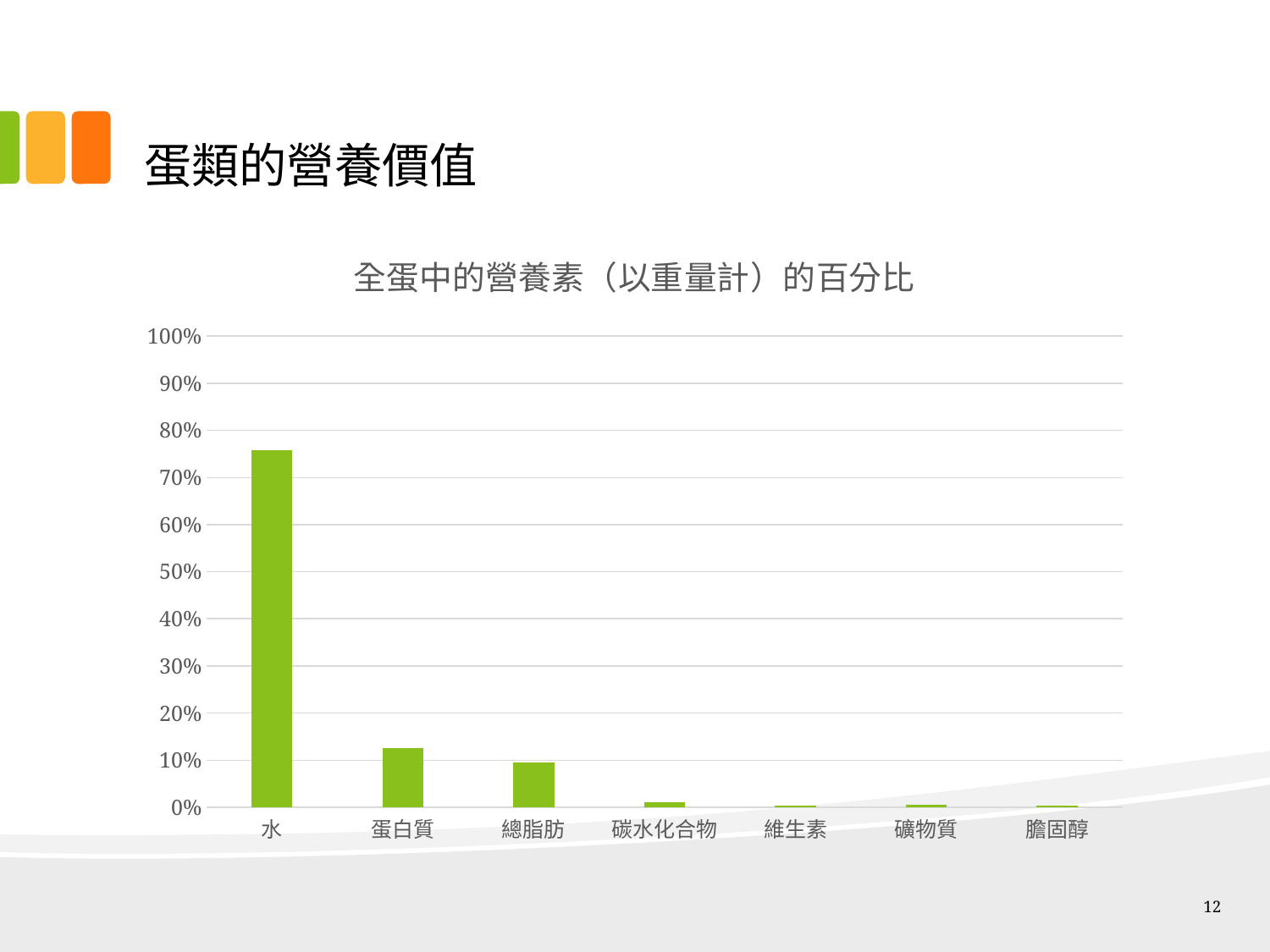
Which is larger, the value for 總脂肪 or the value for 碳水化合物? 總脂肪 Is the value for 水 greater or less than 80%? less Do the values generally rise or fall from left to right along the x axis? fall What is the title of the chart? 全蛋中的營養素（以重量計）的百分比 Which category has the highest value? 水 Which is larger, the value for 蛋白質 or the value for 總脂肪? 蛋白質 Is the value for 碳水化合物 greater or less than 10%? less Is the value for 水 greater or less than 70%? greater What kind of chart is shown on the slide? bar chart How many categories are plotted on the x axis? 7